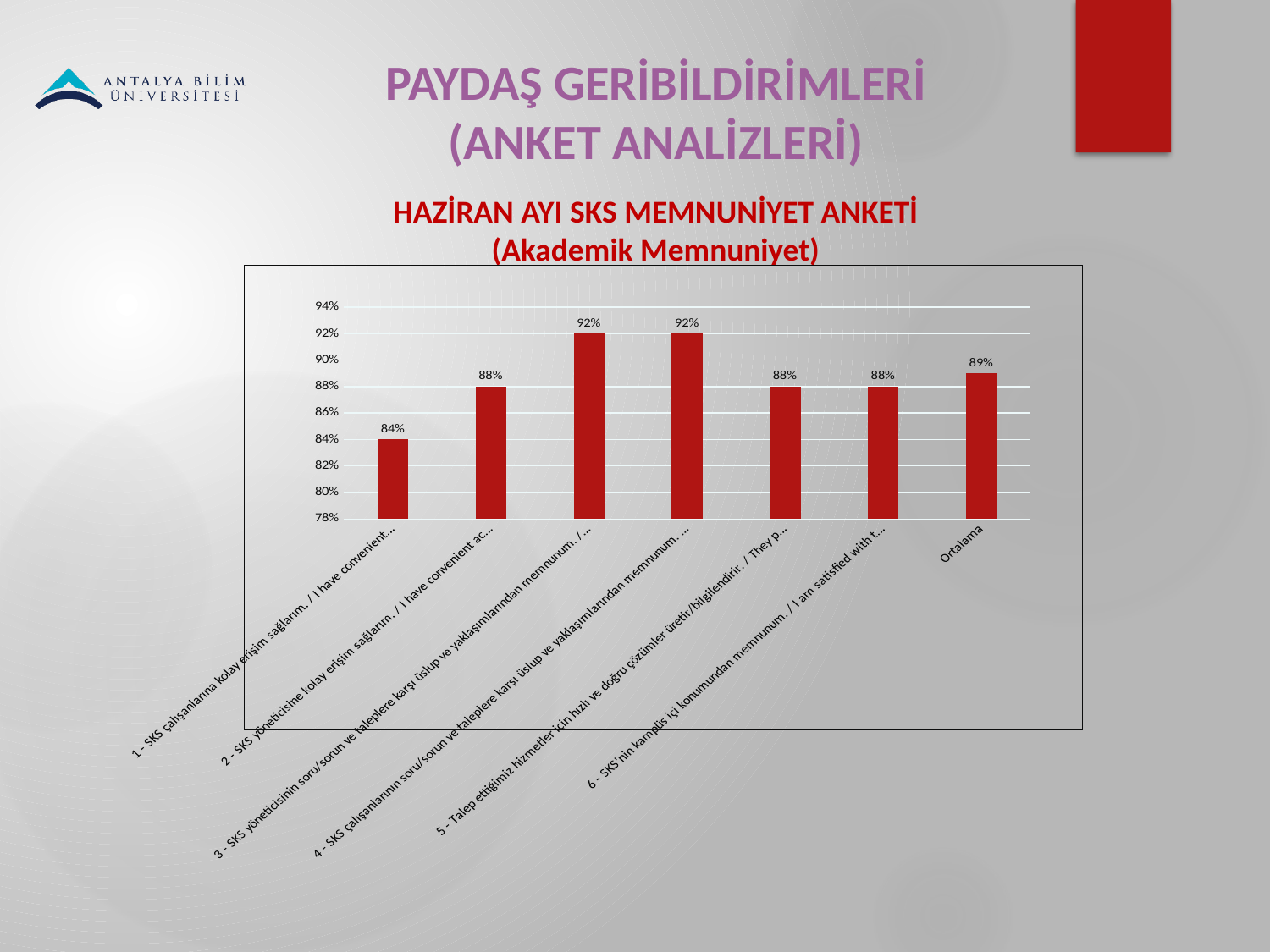
What is the highest value shown in the chart? 92% Which is larger: the value for item 2 or the value for "Ortalama"? Ortalama Which category has the lowest value? 1 - SKS çalışanlarına kolay erişim sağlarım What is the value for item 6 ("SKS'nin kampüs içi konumundan memnunum")? 88% What is the difference between the value for item 3 and the value for item 1? 8% Is the value for item 5 greater or less than 90%? less What is the subtitle of the chart shown on the slide? HAZİRAN AYI SKS MEMNUNİYET ANKETİ (Akademik Memnuniyet) How many bars are shown in the chart? 7 What is the value for item 1 ("SKS çalışanlarına kolay erişim sağlarım")? 84% What is the value for item 3 ("SKS yöneticisinin soru/sorun ve taleplere karşı üslup ve yaklaşımlarından memnunum")? 92% What kind of chart is shown on the slide? Bar chart What is the value for the "Ortalama" bar? 89%